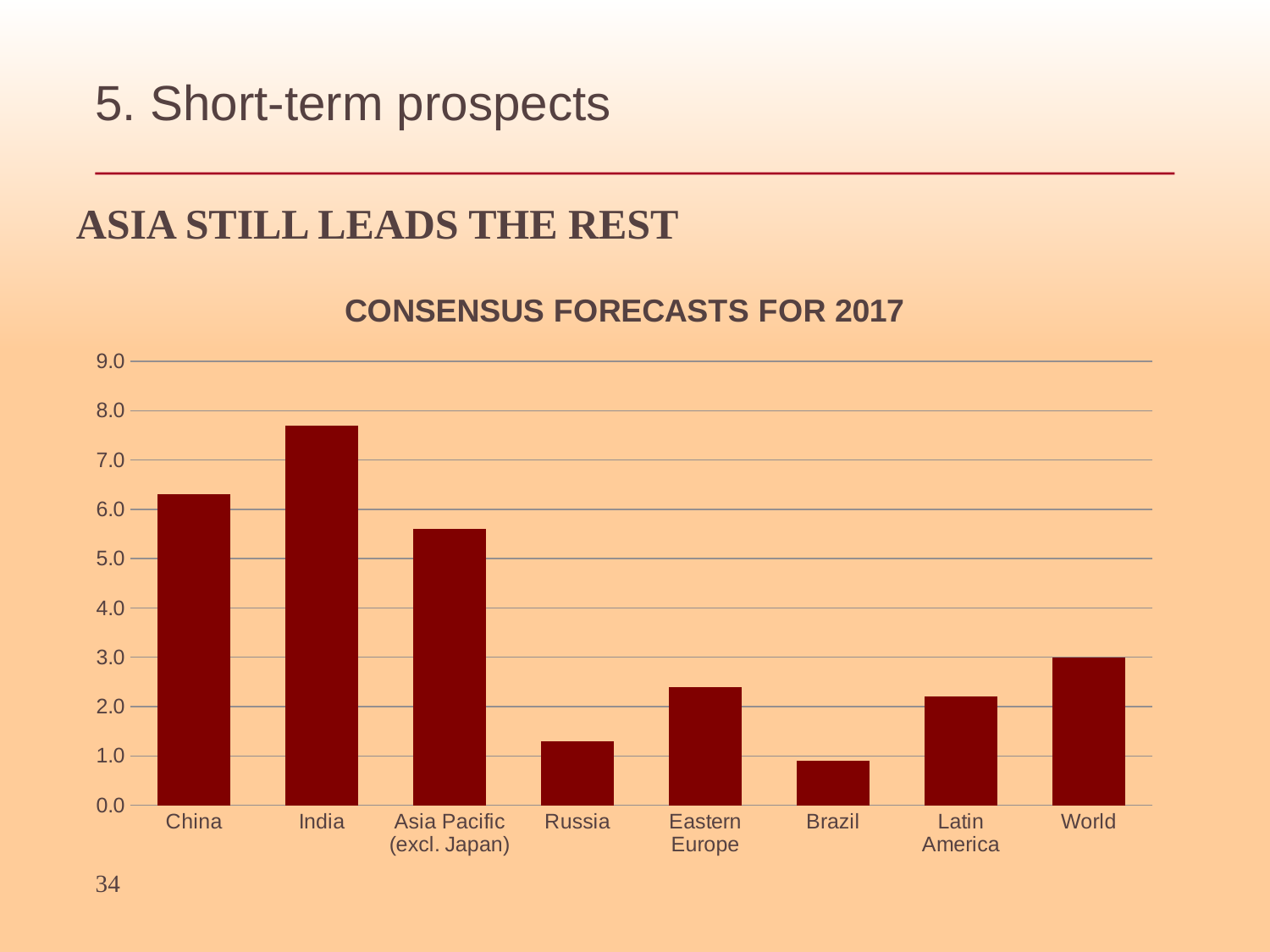
Which category has the lowest forecast value? Brazil What is the title of the chart? CONSENSUS FORECASTS FOR 2017 Is the value for Asia Pacific (excl. Japan) greater or less than 5.0? greater What kind of chart is shown on the slide? Bar chart Is the value for Brazil greater or less than 1.0? less Which category has the highest forecast value? India Which has a higher forecast value, China or Asia Pacific (excl. Japan)? China Which has a higher forecast value, Russia or Eastern Europe? Eastern Europe Is the value for China greater or less than 6.0? greater How many categories are plotted on the chart? 8